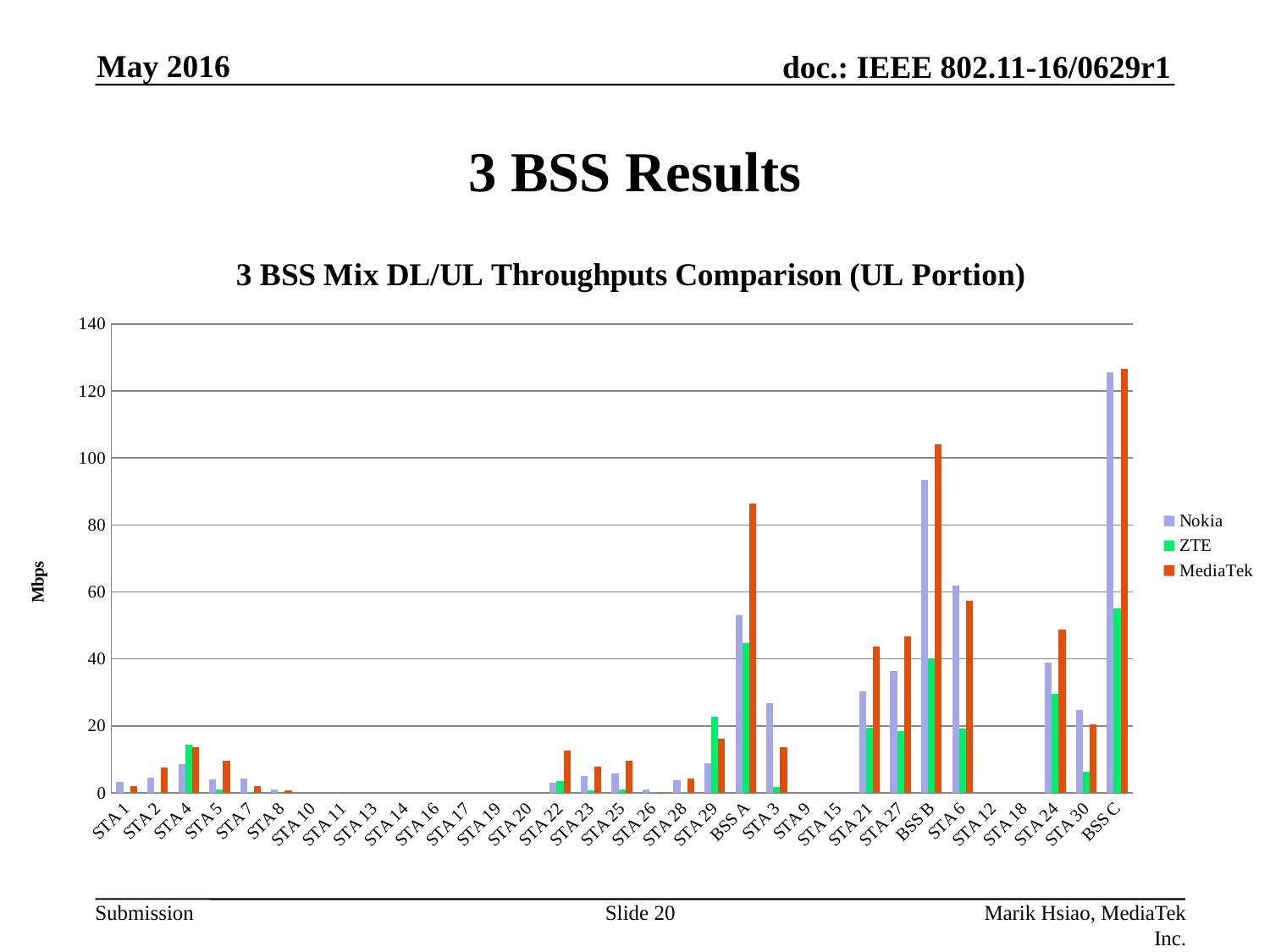
Which category has the highest MediaTek value? BSS C For STA 29, which is larger: the Nokia value or the ZTE value? ZTE Which series are listed in the legend? Nokia, ZTE, MediaTek Is the MediaTek value for BSS A greater or less than 80? greater For BSS B, which is larger: the Nokia value or the MediaTek value? MediaTek What kind of chart is shown on the slide? bar chart Which category has the highest ZTE value? BSS C Is the MediaTek value for BSS B greater or less than 100? greater How many series does the legend list? 3 Is the Nokia value for BSS B greater or less than 100? less What is the label of the vertical axis? Mbps